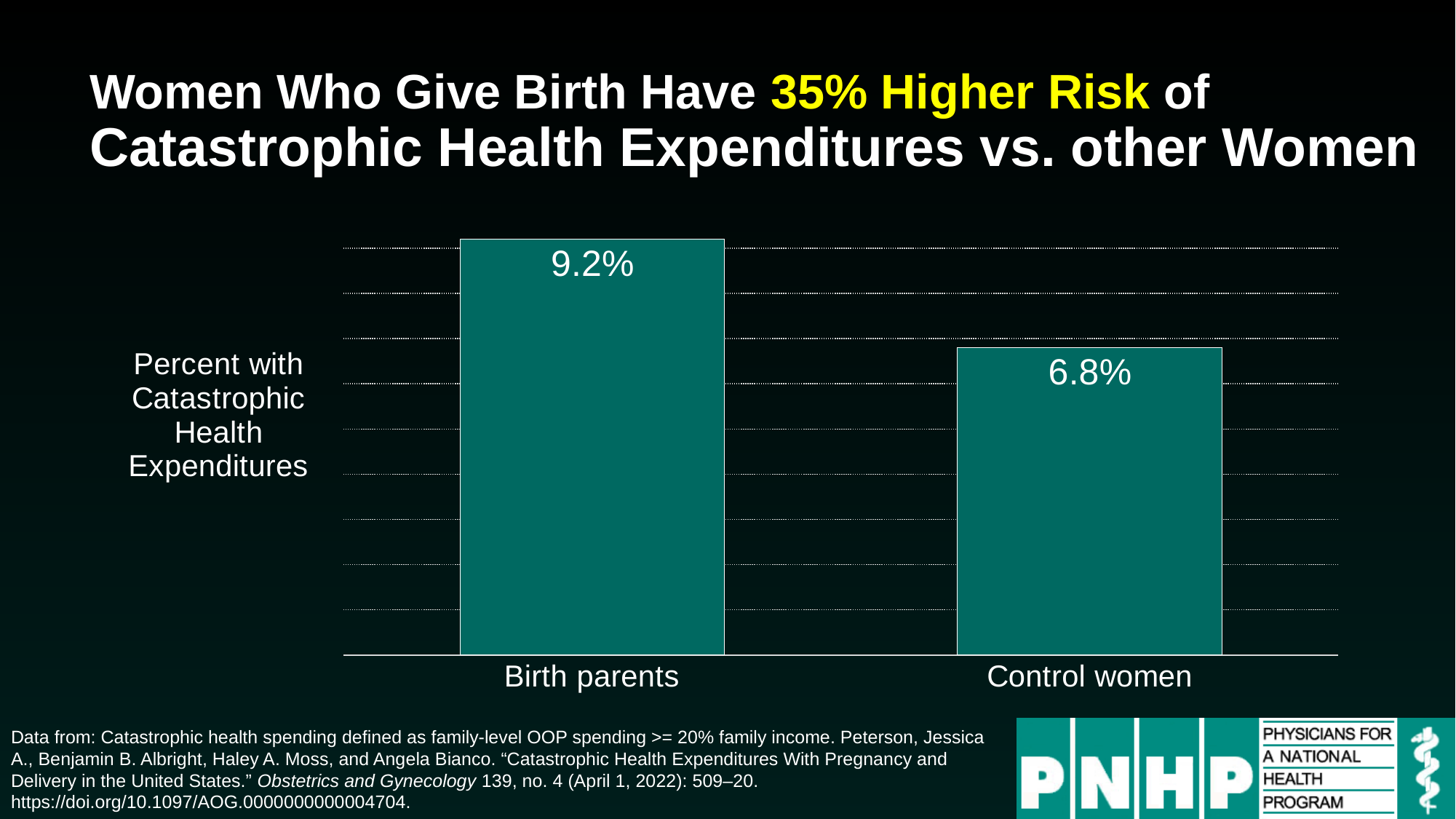
What does the vertical axis label say the chart measures? Percent with Catastrophic Health Expenditures Which category has the lower percent with catastrophic health expenditures? Control women What is the percent with catastrophic health expenditures for Control women? 6.8% How many categories are shown on the chart? 2 Is the value for Birth parents larger or smaller than the value for Control women? larger According to the slide title, how much higher is the risk of catastrophic health expenditures for women who give birth? 35% Which category has the higher percent with catastrophic health expenditures? Birth parents What kind of chart is shown on the slide? bar chart What is the percent with catastrophic health expenditures for Birth parents? 9.2% What is the difference in percentage points between Birth parents and Control women? 2.4